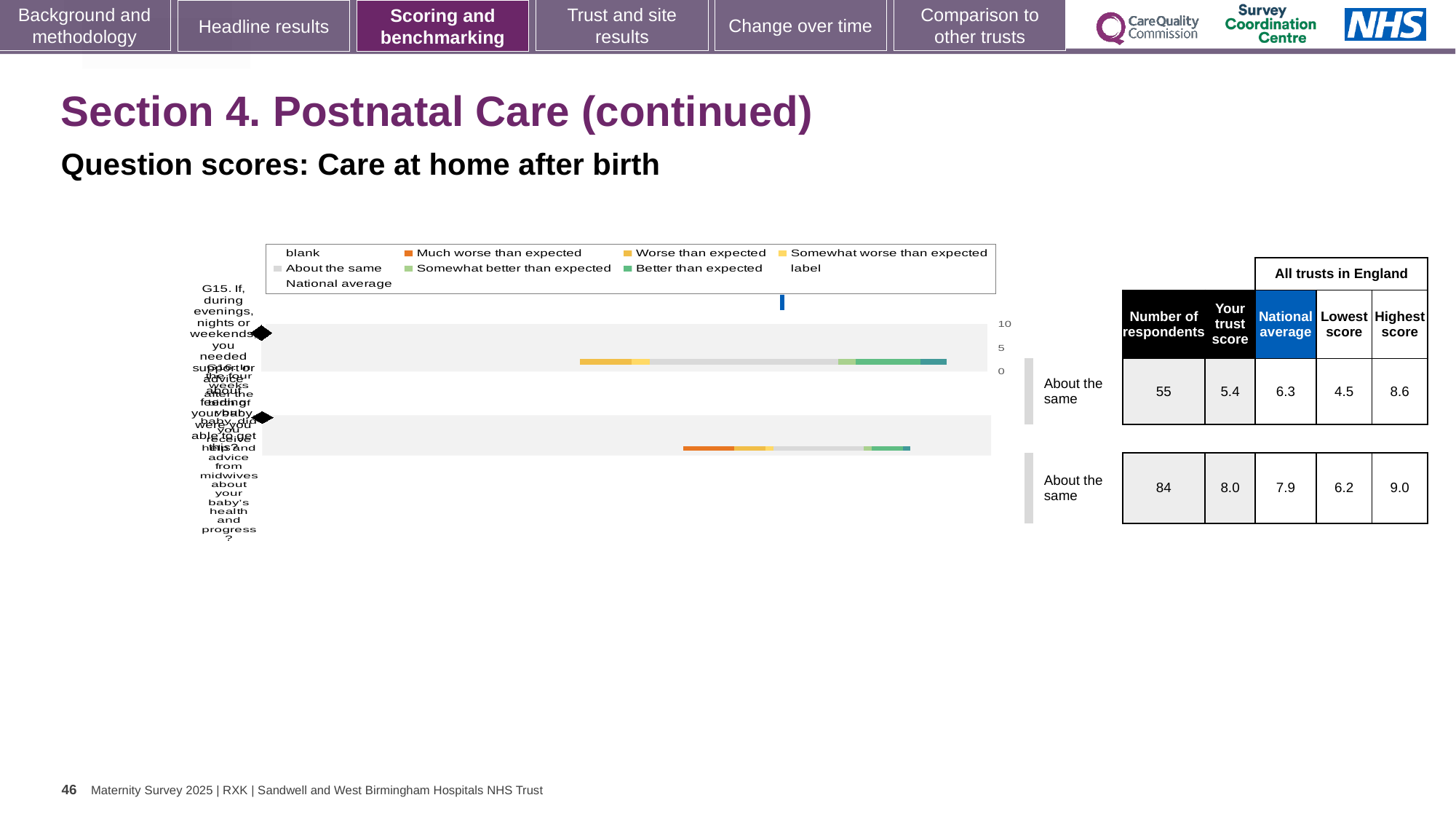
What colour does the legend use for 'Much worse than expected'? orange Which of the two questions has the higher trust score? the second question (G16), 8.0 What is the difference between the highest score and the lowest score for the first question (G15)? 4.1 How many questions (bars) are plotted in the chart? 2 What kind of chart is shown on the slide? bar chart In the table beside the chart, what is the national average for the first question (G15)? 6.3 For the second question (G16), which is larger: the trust score or the national average? the trust score (8.0) What benchmark category is shown for both questions in the chart? About the same What is the difference between the national average and the trust score for the first question (G15)? 0.9 In the table beside the chart, what is the trust score for the second question (G16)? 8.0 In the table beside the chart, what is the number of respondents for the first question (G15)? 55 In the table beside the chart, what is the lowest score for the second question (G16)? 6.2